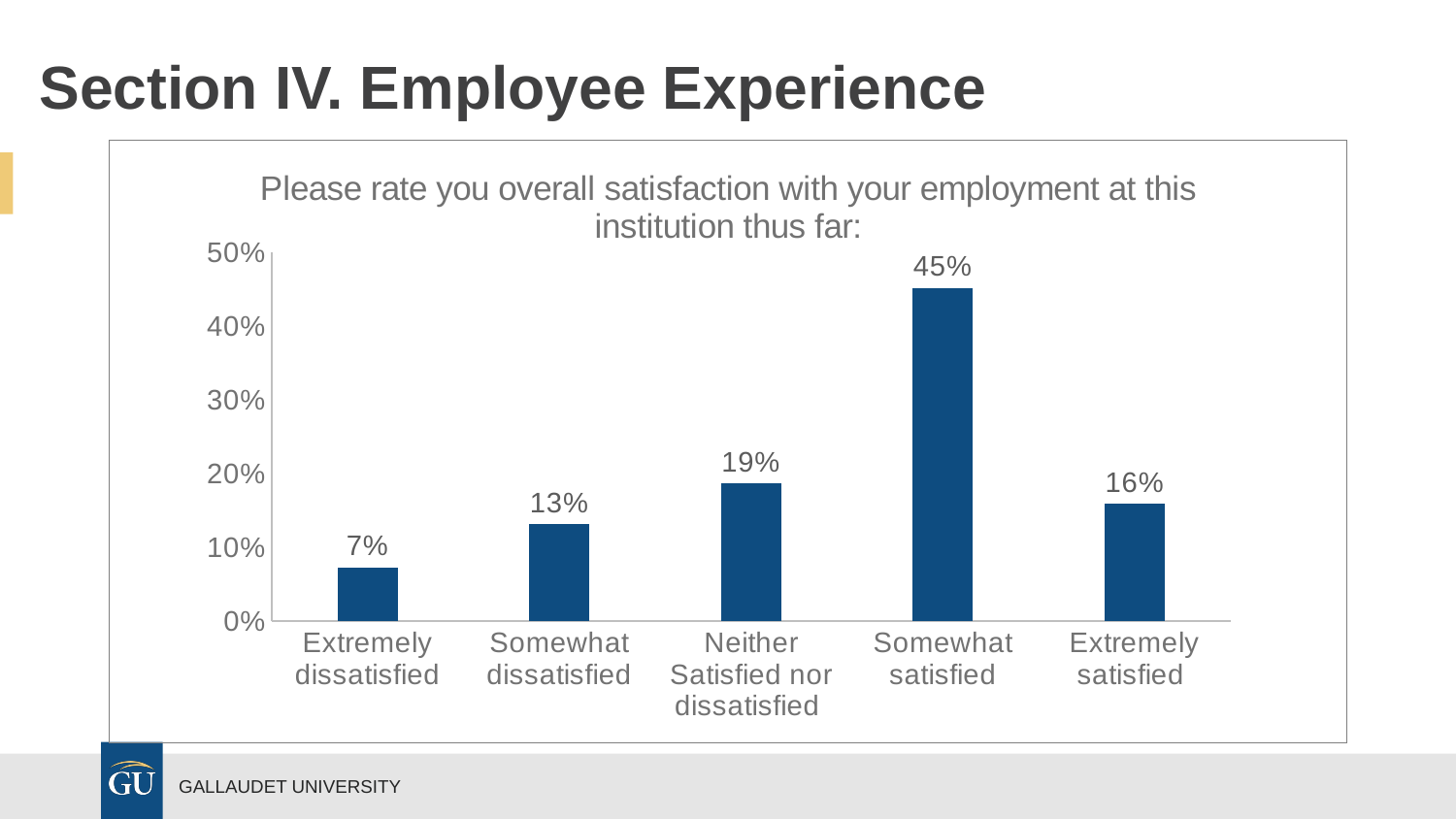
How many categories are shown on the x axis? 5 Is the value for Somewhat satisfied greater or less than 40%? greater What is the difference between Somewhat satisfied and Extremely satisfied? 29% What percentage of respondents are Extremely dissatisfied? 7% What is the value for Neither Satisfied nor dissatisfied? 19% What kind of chart is shown on the slide? bar chart What is the title of the chart? Please rate you overall satisfaction with your employment at this institution thus far: Which is larger, Neither Satisfied nor dissatisfied or Extremely satisfied? Neither Satisfied nor dissatisfied What is the difference between Somewhat dissatisfied and Extremely dissatisfied? 6% What percentage of respondents are Somewhat satisfied? 45% Which category has the lowest value? Extremely dissatisfied Which category has the highest value? Somewhat satisfied